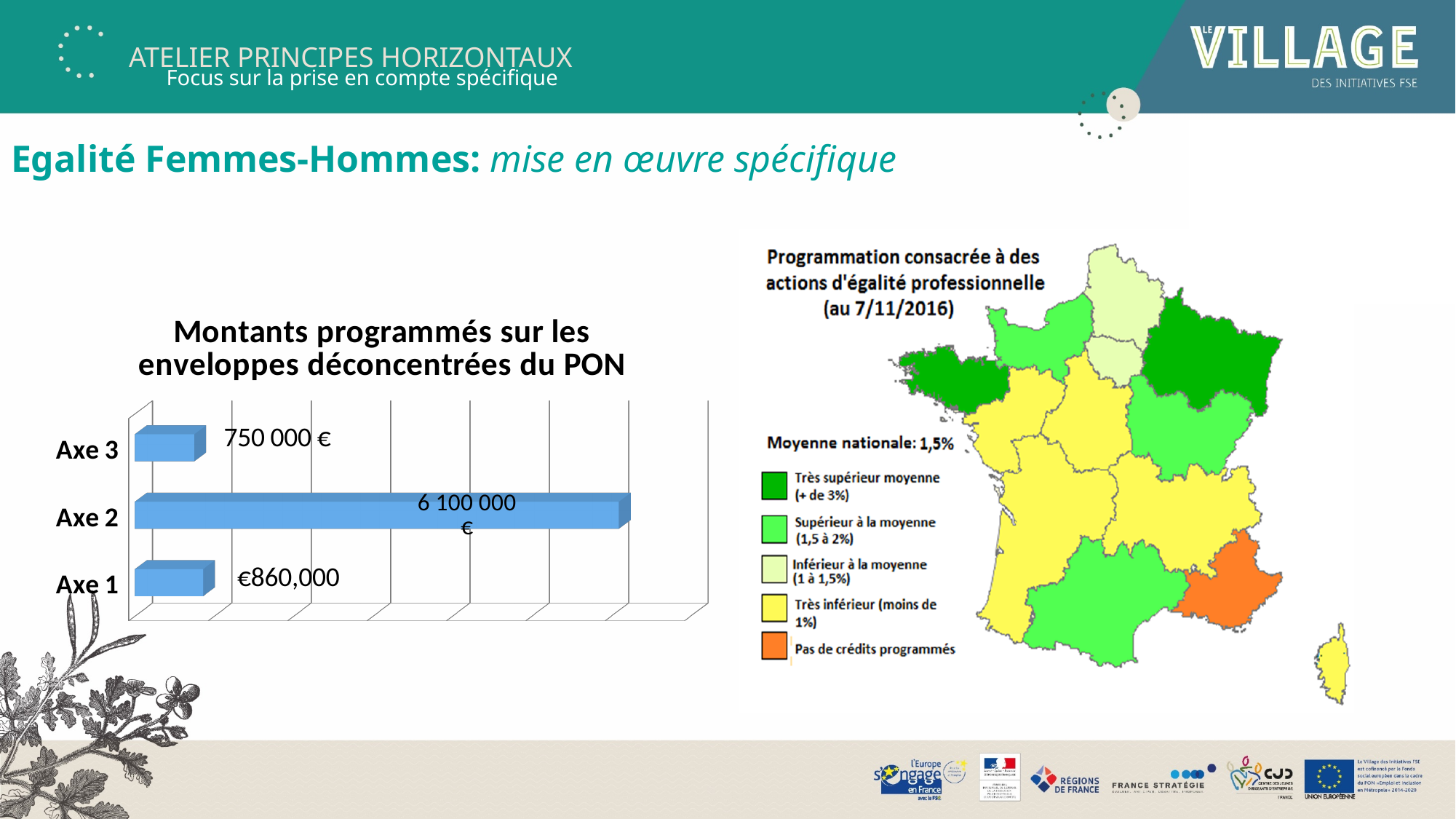
What colour are the bars in the chart 'Montants programmés sur les enveloppes déconcentrées du PON'? Blue In the bar chart, which is larger: the amount for Axe 1 or the amount for Axe 3? Axe 1 How many categories (axes) are shown in the bar chart? 3 What is the value for Axe 2 in the chart 'Montants programmés sur les enveloppes déconcentrées du PON'? 6 100 000 € What is the difference between the amounts for Axe 1 and Axe 3 in the bar chart? 110 000 € What is the difference between the amounts for Axe 2 and Axe 3 in the bar chart? 5 350 000 € What is the title of the bar chart on the left of the slide? Montants programmés sur les enveloppes déconcentrées du PON Which axe has the lowest programmed amount in the bar chart? Axe 3 What kind of chart is 'Montants programmés sur les enveloppes déconcentrées du PON'? Bar chart Which axe has the highest programmed amount in the bar chart? Axe 2 What is the value for Axe 1 in the chart 'Montants programmés sur les enveloppes déconcentrées du PON'? €860,000 What is the value for Axe 3 in the chart 'Montants programmés sur les enveloppes déconcentrées du PON'? 750 000 €